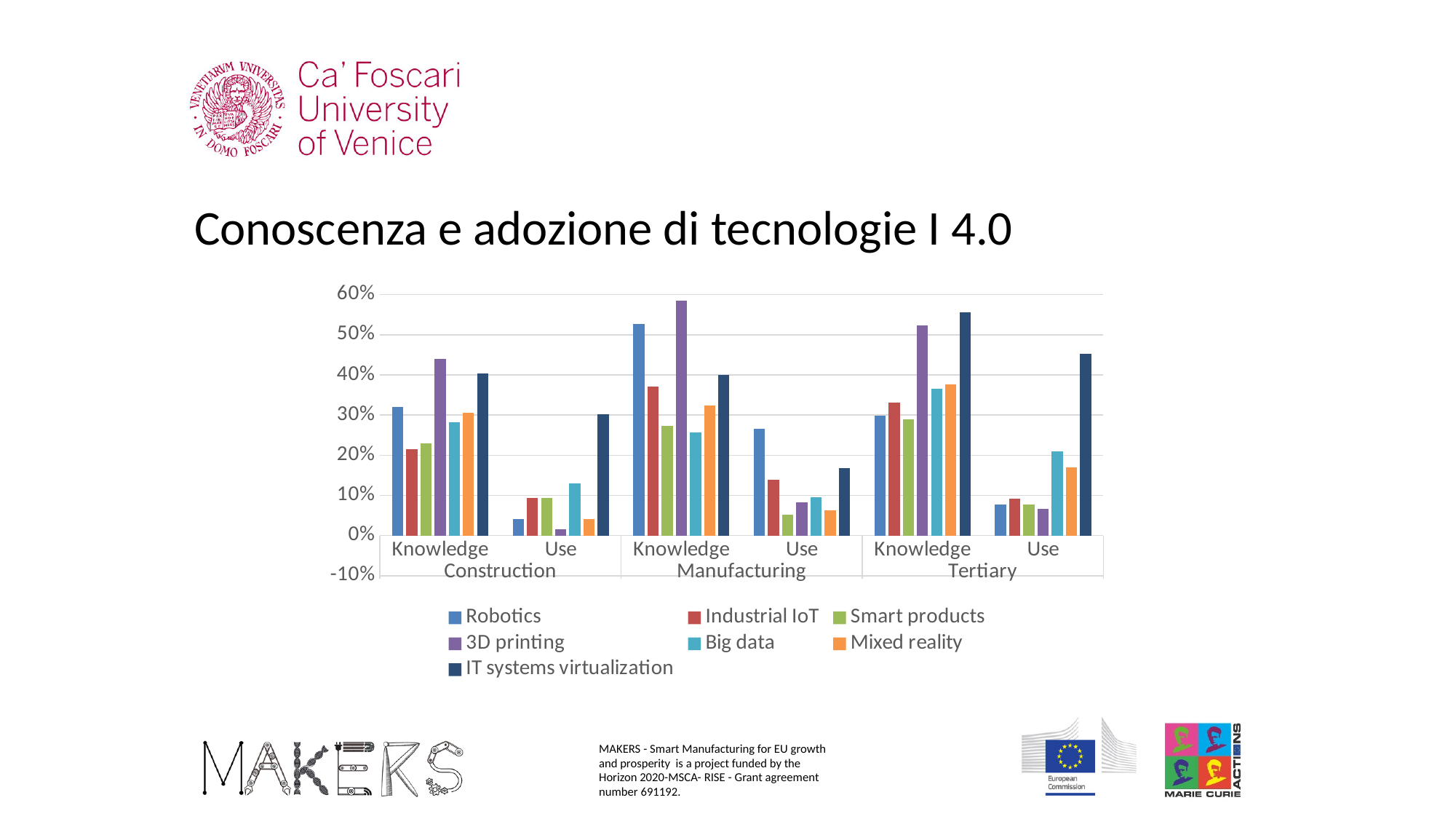
What is the title of the slide above the chart? Conoscenza e adozione di tecnologie I 4.0 In the Manufacturing Knowledge group, which is larger: 3D printing or Robotics? 3D printing What kind of chart is shown on the slide? Bar chart Is the value for IT systems virtualization in the Tertiary Use group greater or less than 40%? greater Is the value for Robotics in the Manufacturing Knowledge group greater or less than 40%? greater Is the value for 3D printing in the Construction Use group greater or less than 10%? less Which series has the lowest bar in the Construction Use group? 3D printing Which series has the highest bar in the Tertiary Use group? IT systems virtualization In the Tertiary Use group, which is larger: Big data or Mixed reality? Big data How many series does the legend list? 7 How many sectors are shown along the x axis? 3 Which series has the highest bar in the Construction Use group? IT systems virtualization